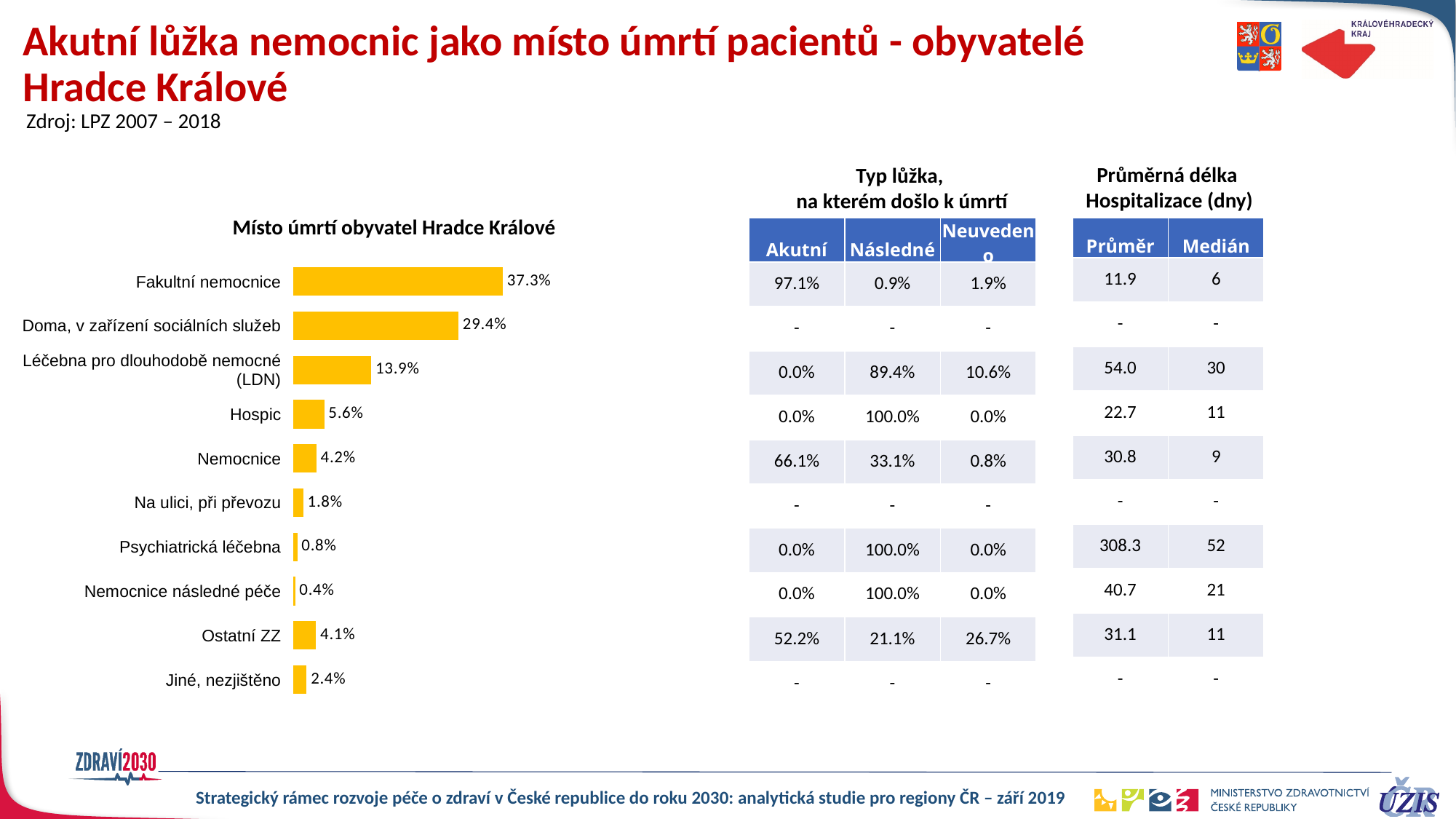
What percentage is shown for 'Doma, v zařízení sociálních služeb'? 29.4% What is the value for Hospic in the bar chart? 5.6% Which is larger in the bar chart: Hospic or Nemocnice? Hospic What is the difference between the values for Fakultní nemocnice and 'Doma, v zařízení sociálních služeb'? 7.9 percentage points Which category has the lowest value in the bar chart? Nemocnice následné péče What value is shown for 'Léčebna pro dlouhodobě nemocné (LDN)'? 13.9% Which category has the highest value in the chart 'Místo úmrtí obyvatel Hradce Králové'? Fakultní nemocnice What is the value for Fakultní nemocnice in the chart 'Místo úmrtí obyvatel Hradce Králové'? 37.3% How many categories are shown in the chart 'Místo úmrtí obyvatel Hradce Králové'? 10 What kind of chart is 'Místo úmrtí obyvatel Hradce Králové'? Bar chart What colour are the bars in the chart 'Místo úmrtí obyvatel Hradce Králové'? Yellow What is the value for 'Na ulici, při převozu' in the bar chart? 1.8%